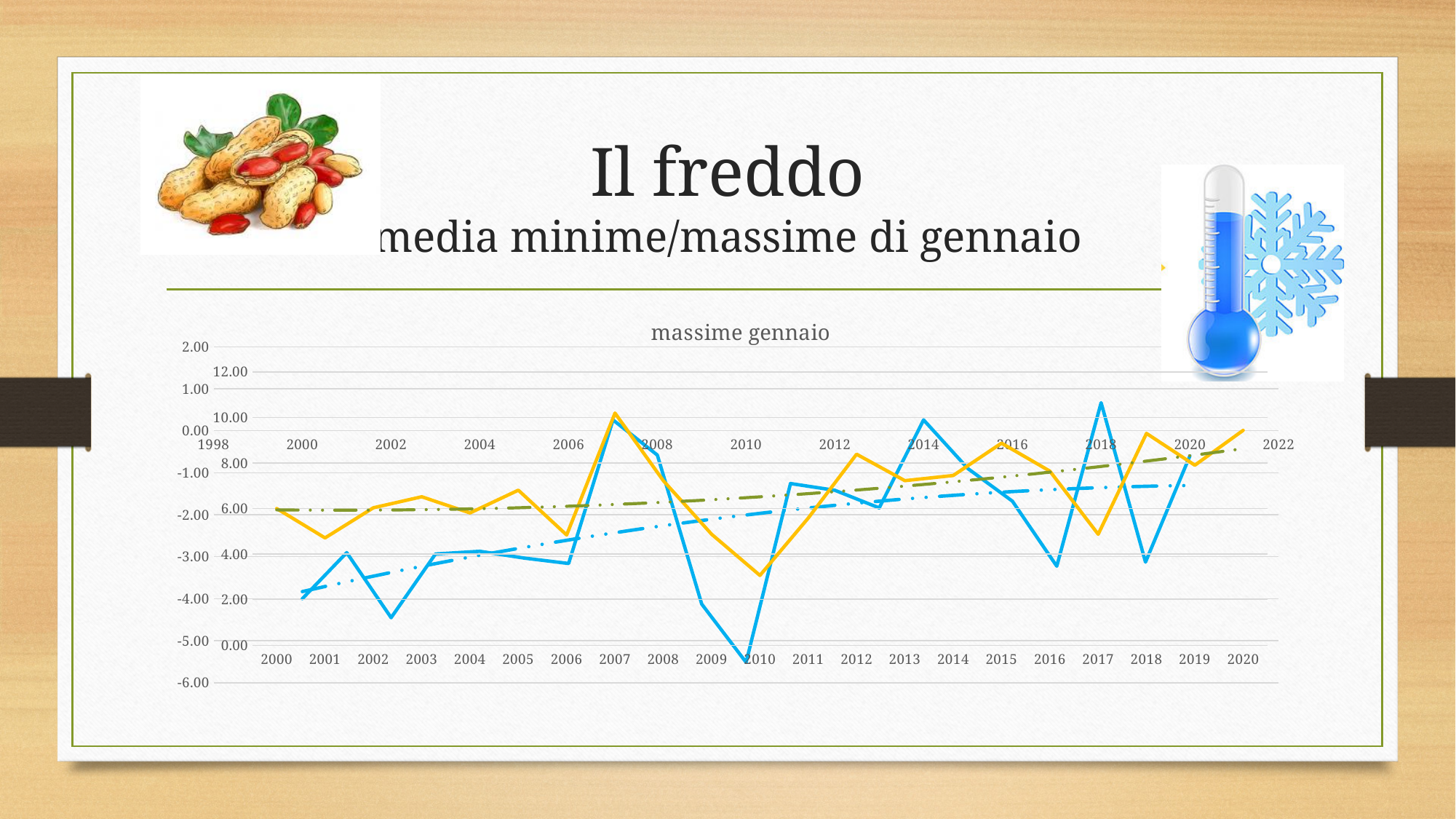
In the 'massime gennaio' chart, is the yellow line's value for 2007 greater or less than 8.00? greater In the chart whose y-axis runs from -6.00 to 2.00, is the blue line's value for 2010 greater or less than -5.00? less In the 'massime gennaio' chart, is the yellow line's value for 2015 greater or less than 8.00? greater What kind of chart is the 'massime gennaio' chart? line chart In the 'massime gennaio' chart, which year has the larger value on the yellow line, 2007 or 2010? 2007 What is the title of the chart whose y-axis runs from 0.00 to 12.00? massime gennaio In the 'massime gennaio' chart, does the dashed trend line for the yellow series rise or fall from 2000 to 2020? rise In the chart whose y-axis runs from -6.00 to 2.00, which year has the lowest value on the blue line? 2010 In the 'massime gennaio' chart, how many years are labelled on the x-axis? 21 In the 'massime gennaio' chart, which year has the lowest value on the yellow line? 2010